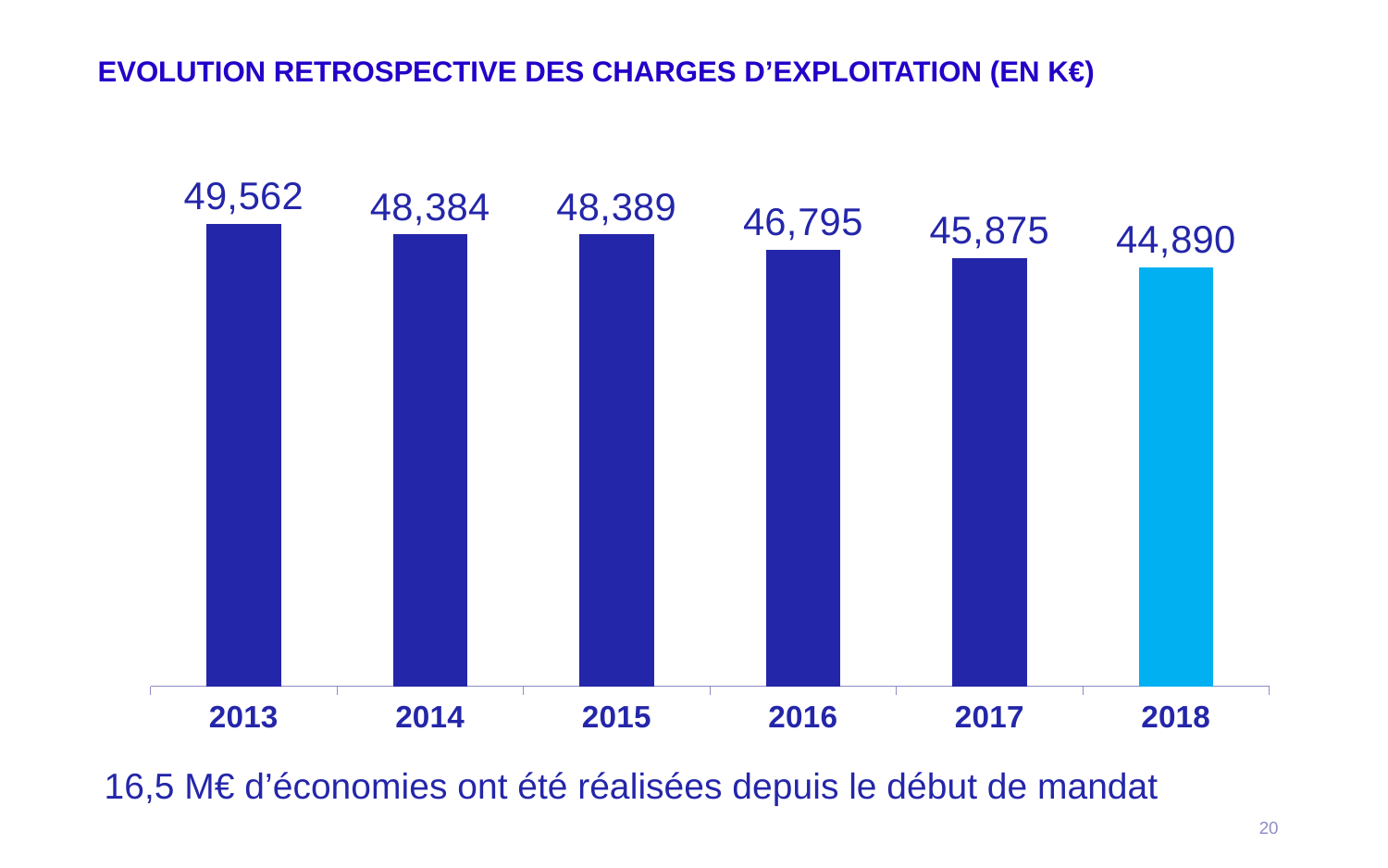
What is the value for 2013? 49,562 What is the difference between the values for 2016 and 2017? 920 Which year's bar is shown in a different (light blue) colour from the others? 2018 Which year has the lowest value? 2018 Which is larger, the value for 2015 or the value for 2017? 2015 Which year has the highest value? 2013 What kind of chart is shown on the slide? Bar chart What is the difference between the values for 2013 and 2018? 4,672 What is the value for 2016? 46,795 Do the values generally rise or fall from 2013 to 2018? Fall How many years are shown on the chart? 6 What is the value for 2018? 44,890